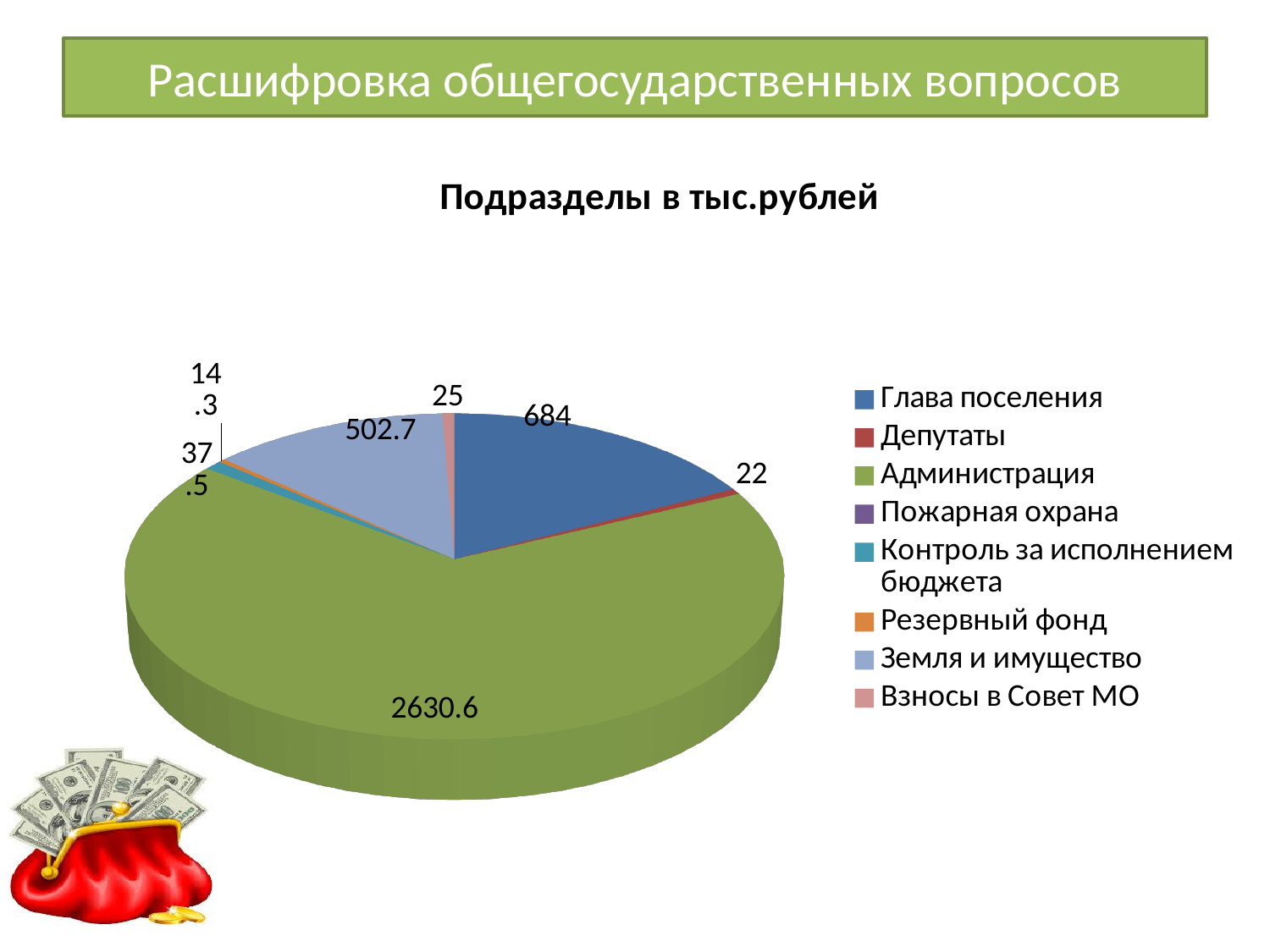
What is the difference between the values for Глава поселения and Земля и имущество? 181.3 Which is larger, the value for Глава поселения or the value for Земля и имущество? Глава поселения What is the value for Взносы в Совет МО in the pie chart? 25 How many entries does the legend of the chart list? 8 Which category has the largest slice in the pie chart? Администрация What is the value for Администрация in the pie chart? 2630.6 What is the title of the chart? Подразделы в тыс.рублей What type of chart is shown on the slide? Pie chart What is the value for Глава поселения in the pie chart? 684 What is the value for Депутаты in the pie chart? 22 What is the value for Земля и имущество in the pie chart? 502.7 What is the difference between the values for Взносы в Совет МО and Депутаты? 3